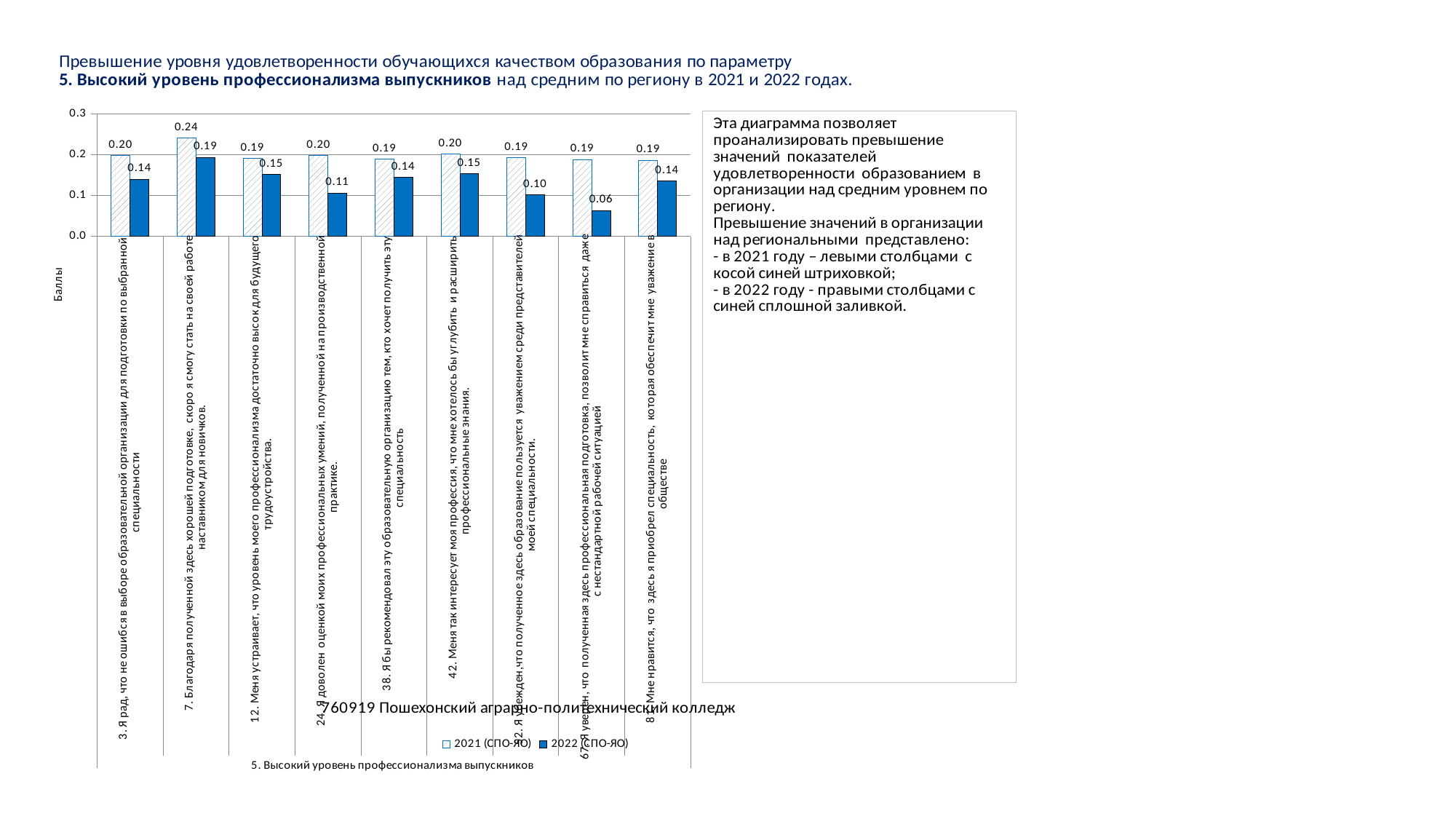
How many categories (statements) are shown on the x axis of the chart? 9 What is the 2022 (СПО-ЯО) value for item 67 ("Я уверен, что полученная здесь профессиональная подготовка...")? 0.06 For item 3 ("Я рад, что не ошибся в выборе образовательной организации..."), which is larger: the 2021 value or the 2022 value? 2021 (СПО-ЯО) What is the 2021 (СПО-ЯО) value for item 7 ("Благодаря полученной здесь хорошей подготовке...")? 0.24 What type of chart is shown on the slide? Bar chart Which category has the highest 2021 (СПО-ЯО) value? 7. Благодаря полученной здесь хорошей подготовке, скоро я смогу стать на своей работе наставником для новичков. What is the 2022 (СПО-ЯО) value for item 24 ("Я доволен оценкой моих профессиональных умений...")? 0.11 What is the difference between the 2021 and 2022 values for item 7? 0.05 What is the difference between the 2021 and 2022 values for item 52 ("Я убежден, что полученное здесь образование пользуется уважением...")? 0.09 How many series does the legend list? 2 Which category has the lowest 2022 (СПО-ЯО) value? 67. Я уверен, что полученная здесь профессиональная подготовка, позволит мне справиться даже с нестандартной рабочей ситуацией What is the title of the vertical axis of the chart? Баллы